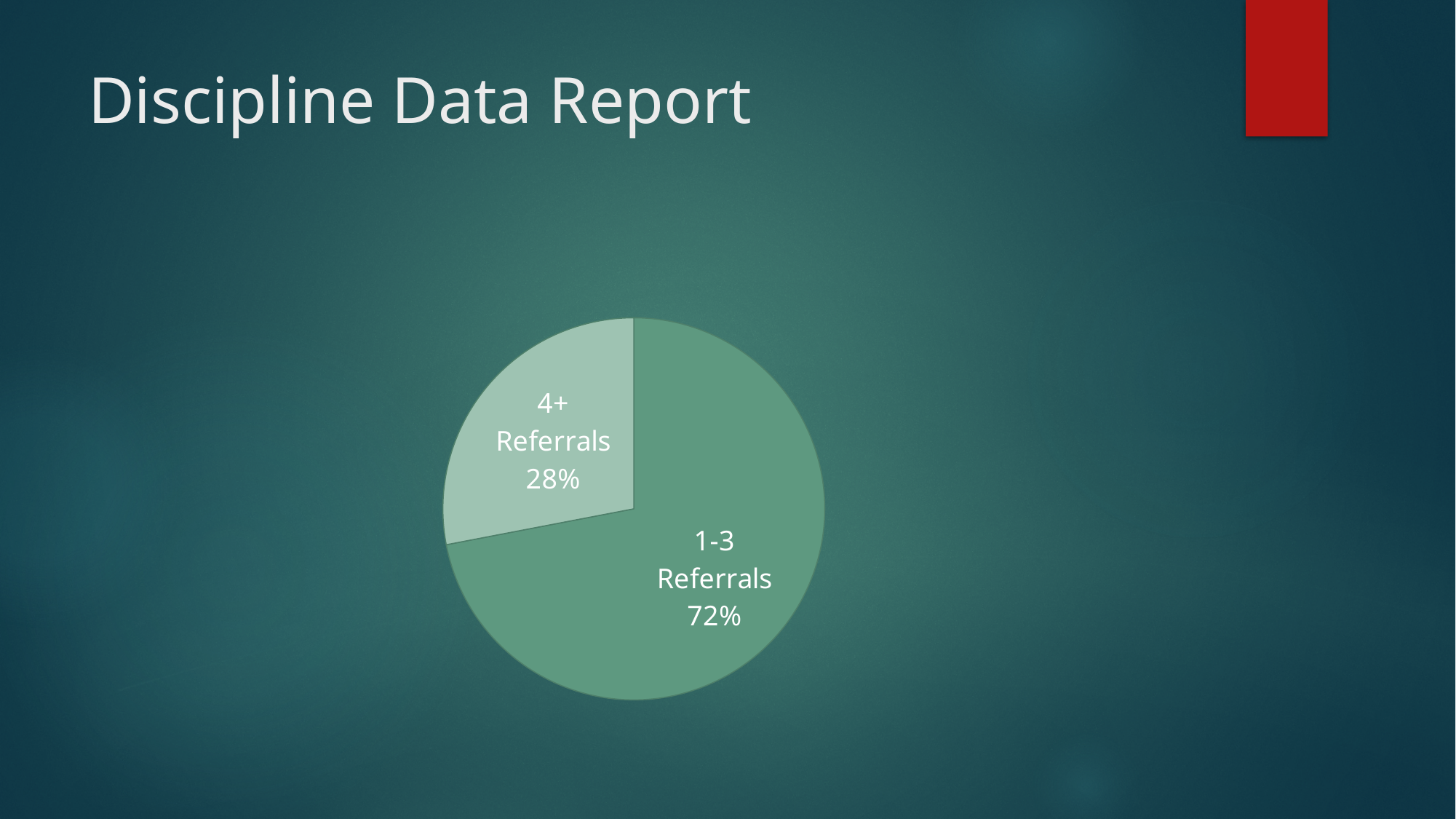
What kind of chart is shown on the slide? pie chart Which is larger, the 1-3 Referrals slice or the 4+ Referrals slice? 1-3 Referrals What is the title of the slide containing the pie chart? Discipline Data Report Which slice of the pie is the smallest? 4+ Referrals Which slice of the pie is the largest? 1-3 Referrals What share of the pie is labelled 1-3 Referrals? 72% How many slices does the pie chart have? 2 What share of the pie is labelled 4+ Referrals? 28% What is the combined share of the two slices in the pie chart? 100% Which slice of the pie is shown in the lighter green colour? 4+ Referrals What is the difference in percentage points between the 1-3 Referrals slice and the 4+ Referrals slice? 44